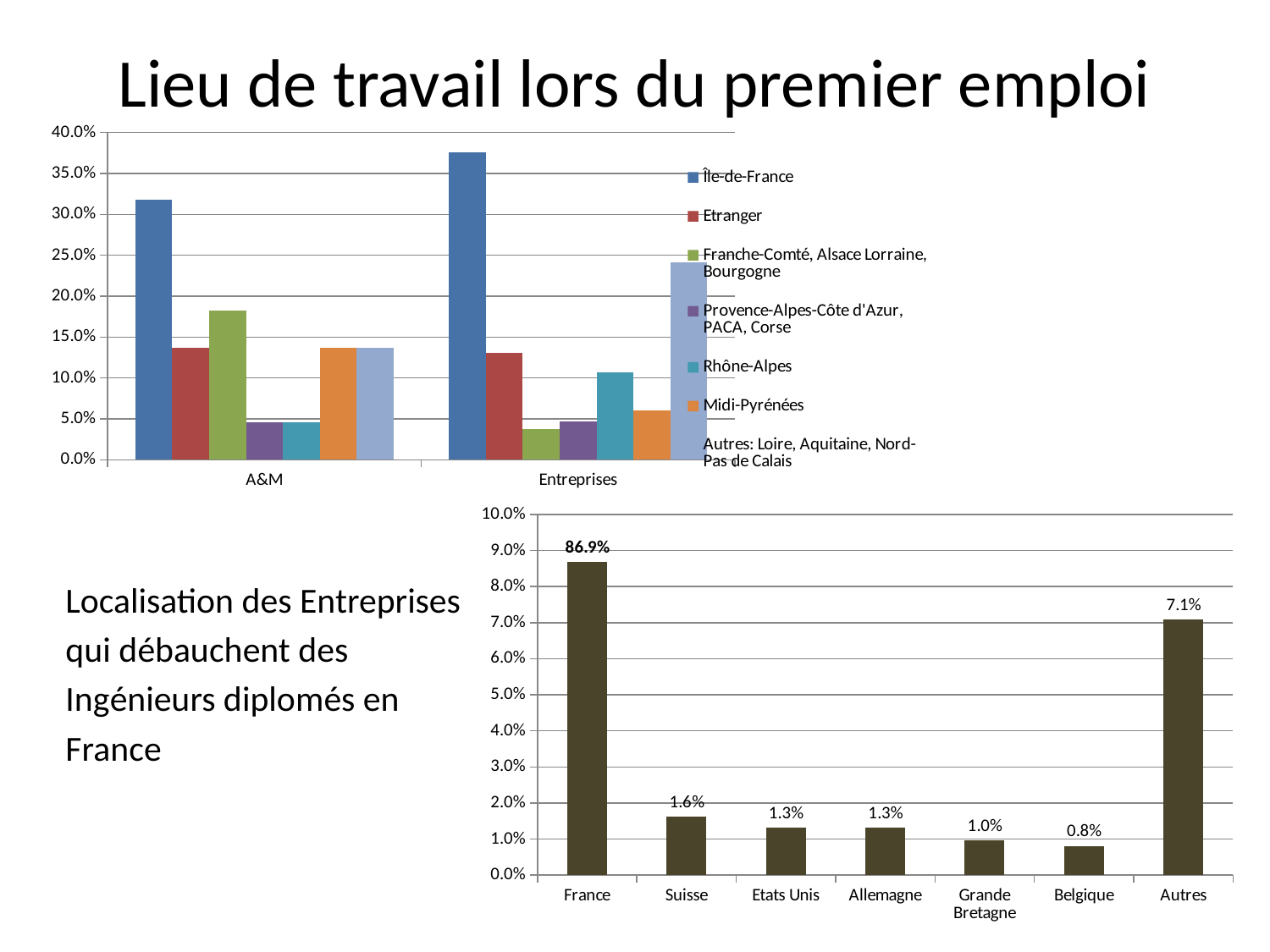
On the bottom chart, what is the difference between the values for Suisse and Grande Bretagne? 0.6% On the top chart, is the value for Île-de-France in the Entreprises group greater or less than 35%? greater On the bottom chart, which category has the lowest value? Belgique What kind of chart is the bottom chart? Bar chart On the bottom chart, what is the value for France? 86.9% On the top chart, how many series does the legend list? 7 On the bottom chart, which is larger, the value for Suisse or the value for Allemagne? Suisse On the top chart, is the value for Franche-Comté, Alsace Lorraine, Bourgogne in the A&M group greater or less than 15%? greater On the bottom chart, how many categories are shown on the x axis? 7 On the bottom chart, what is the value for Belgique? 0.8% On the top chart, which series has the tallest bar in the A&M group? Île-de-France On the bottom chart, what is the value for Autres? 7.1%